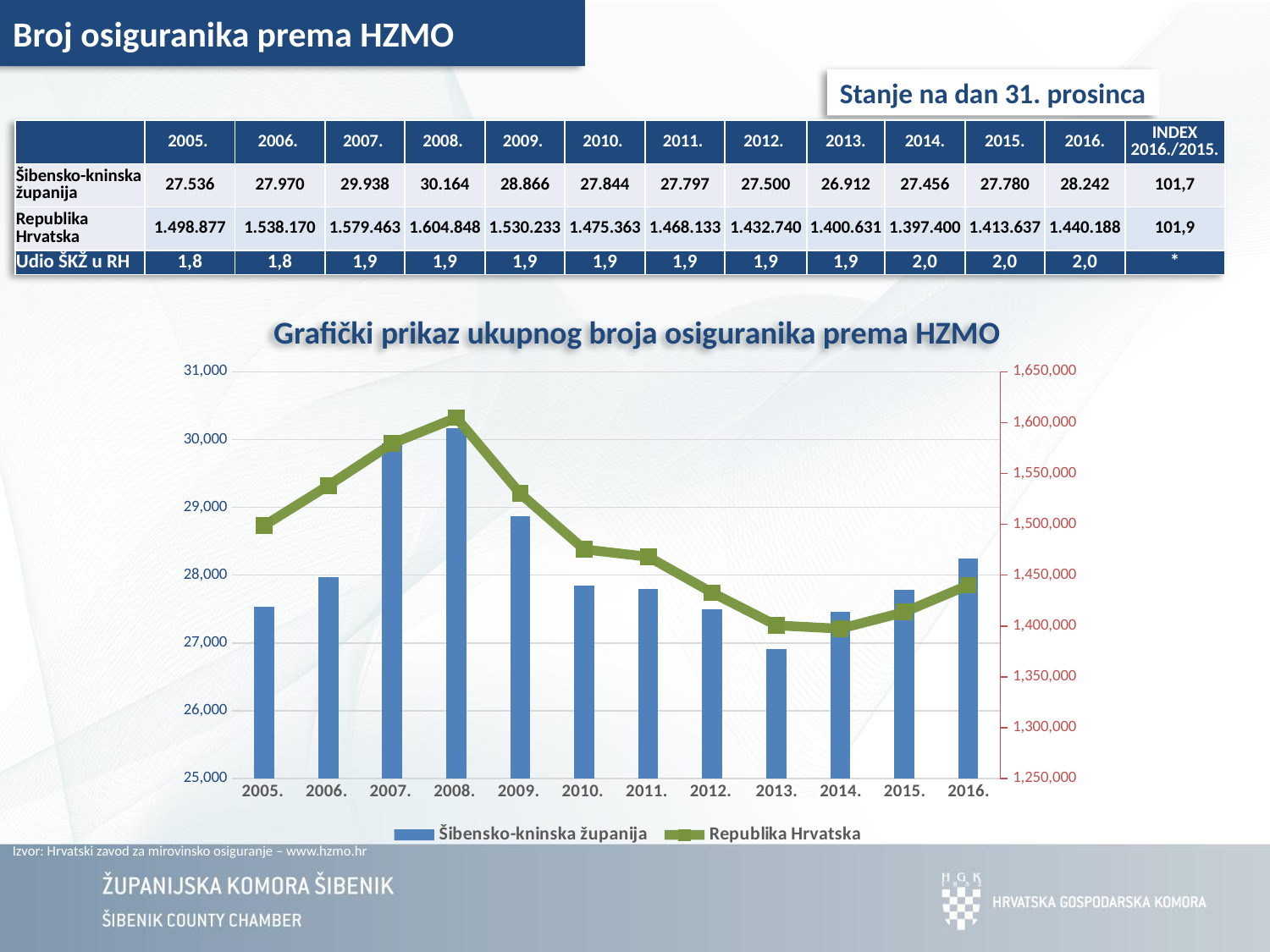
What kind of chart is shown under the title 'Grafički prikaz ukupnog broja osiguranika prema HZMO'? A combined bar and line chart Do the values for Republika Hrvatska rise or fall from 2008. to 2013.? fall In which year does the Republika Hrvatska line reach its highest point? 2008. Which series is drawn as a line in the chart? Republika Hrvatska Which is larger for Šibensko-kninska županija: the value in 2007. or the value in 2011.? 2007. In which year is the bar for Šibensko-kninska županija highest? 2008. Is the value for Republika Hrvatska in 2010. greater or less than 1,500,000? less How many series does the chart legend list? 2 How many years are shown on the x axis of the chart? 12 In which year is the bar for Šibensko-kninska županija lowest? 2013. Is the value for Šibensko-kninska županija in 2013. greater or less than 27,000? less Is the value for Šibensko-kninska županija in 2016. greater or less than 28,000? greater